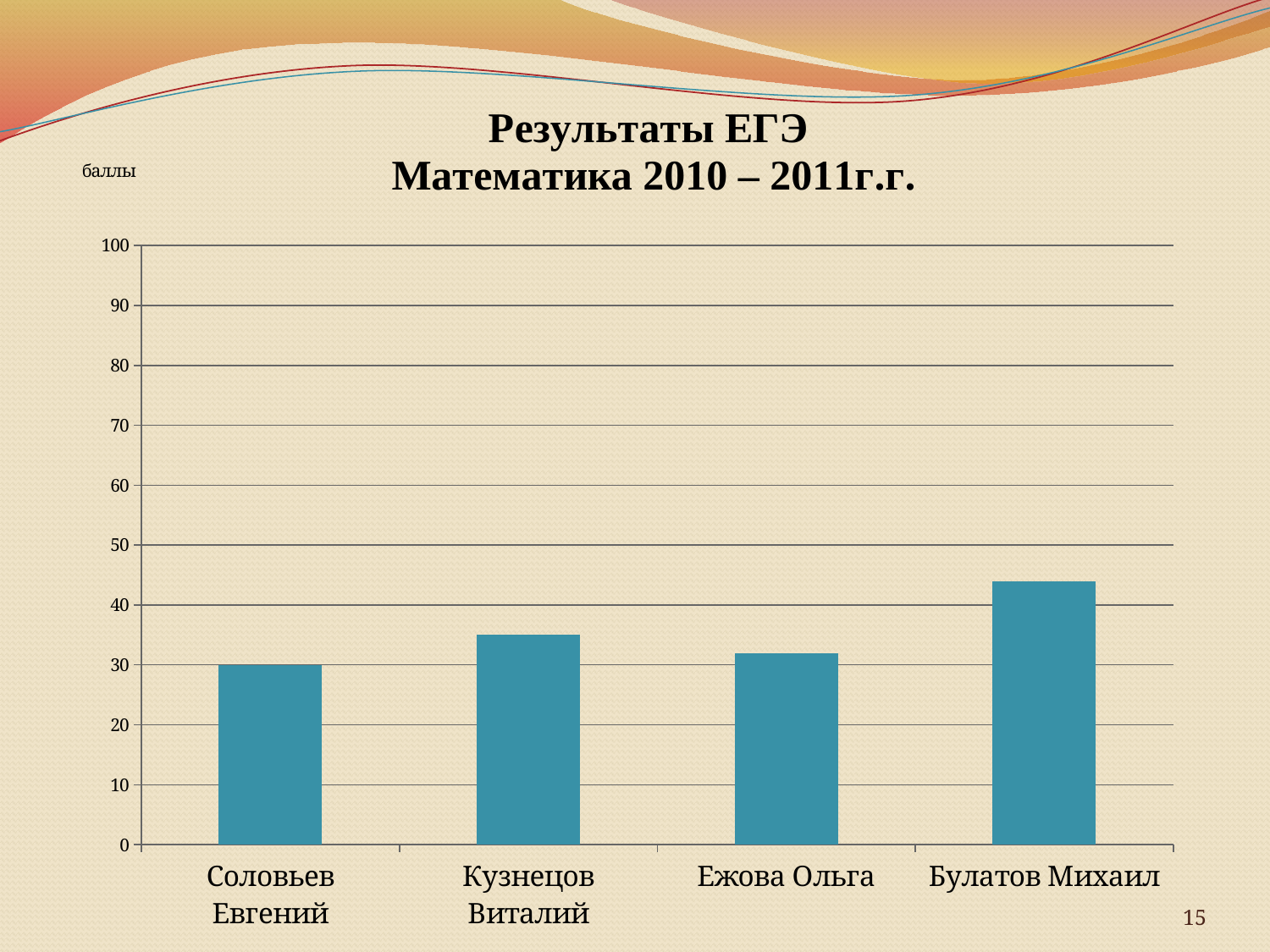
Is the value for Булатов Михаил greater or less than 50? less Which student has the lowest score on the chart? Соловьев Евгений What is the title of the chart? Результаты ЕГЭ Математика 2010 – 2011г.г. How many students (categories) are shown on the chart? 4 What is the value for Соловьев Евгений? 30 Which is larger, the value for Булатов Михаил or the value for Соловьев Евгений? Булатов Михаил Is the value for Ежова Ольга greater or less than 30? greater What kind of chart is shown on the slide? bar chart Which student has the highest score on the chart? Булатов Михаил Is the value for Булатов Михаил greater or less than 40? greater Which is larger, the value for Кузнецов Виталий or the value for Ежова Ольга? Кузнецов Виталий